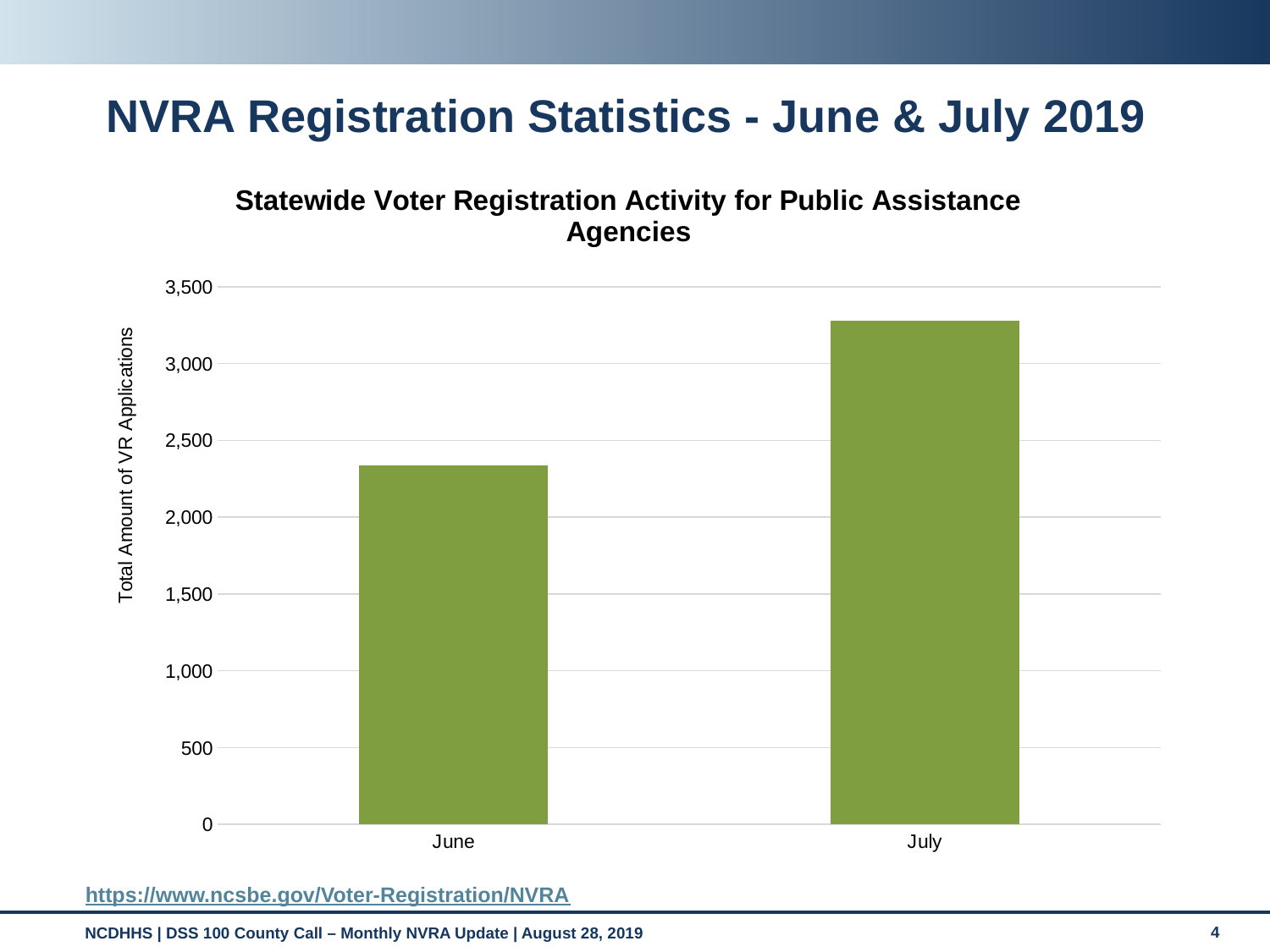
Which is larger, the value for June or the value for July? July Which month has the highest total amount of VR applications? July Which month has the lowest total amount of VR applications? June How many categories are plotted on the x axis of the chart? 2 Is the value for July greater or less than 3,500? less Do the values rise or fall from June to July? rise What is the label on the y axis of the chart? Total Amount of VR Applications Is the value for June greater or less than 2,000? greater What is the title of the chart? Statewide Voter Registration Activity for Public Assistance Agencies Is the value for July greater or less than 3,000? greater What kind of chart is shown on the slide? bar chart